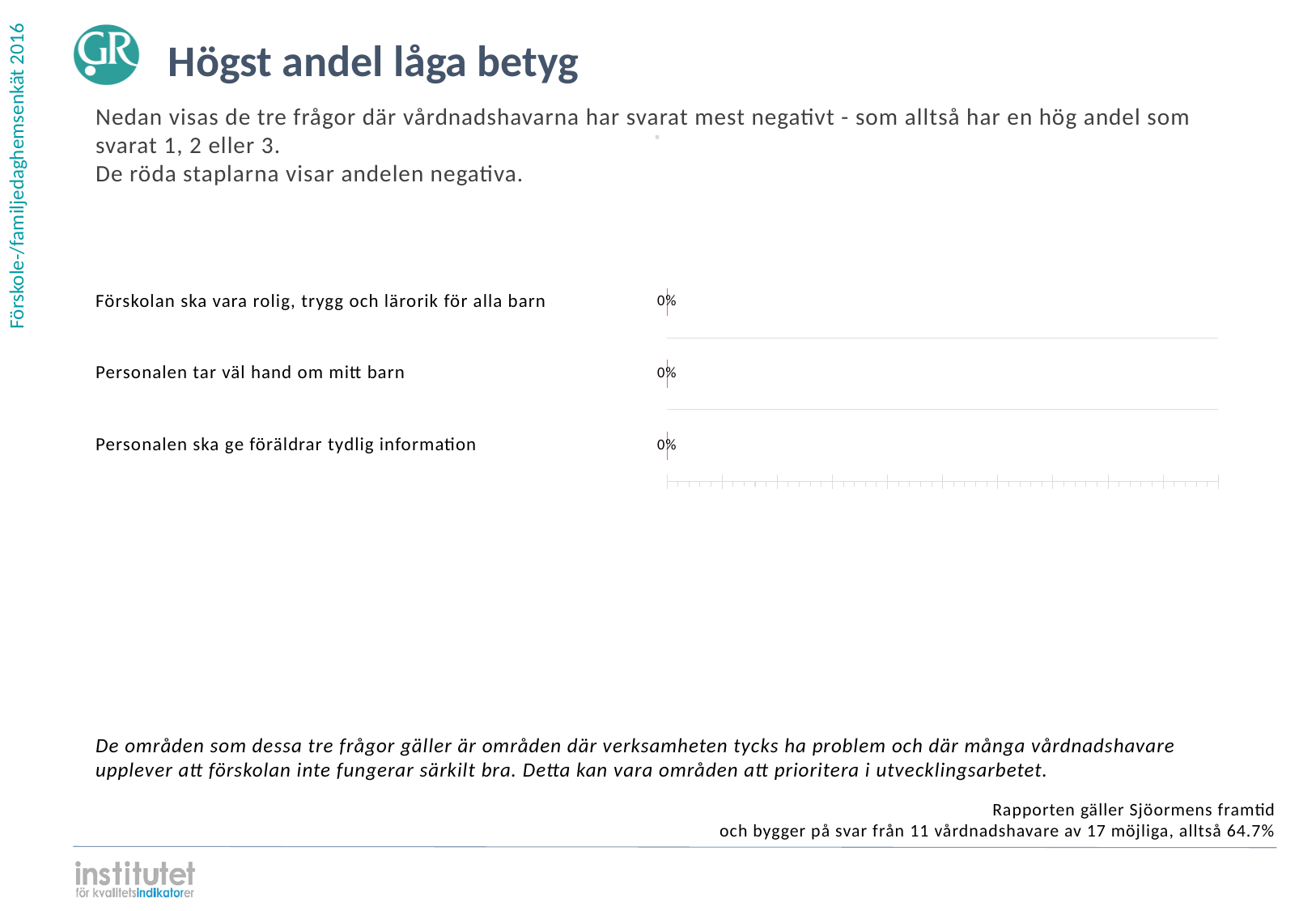
What is the value shown for "Förskolan ska vara rolig, trygg och lärorik för alla barn"? 0% What is the title of the slide containing the chart? Högst andel låga betyg What is the difference between the values for "Personalen tar väl hand om mitt barn" and "Personalen ska ge föräldrar tydlig information"? 0% How many categories are shown in the chart? 3 What kind of chart is shown on the slide? Bar chart According to the slide text, what colour are the bars that show the share of negative answers? Red What is the difference between the values for "Förskolan ska vara rolig, trygg och lärorik för alla barn" and "Personalen tar väl hand om mitt barn"? 0% What is the value shown for "Personalen tar väl hand om mitt barn"? 0% Do all three categories in the chart have the same value? Yes What is the value shown for "Personalen ska ge föräldrar tydlig information"? 0%